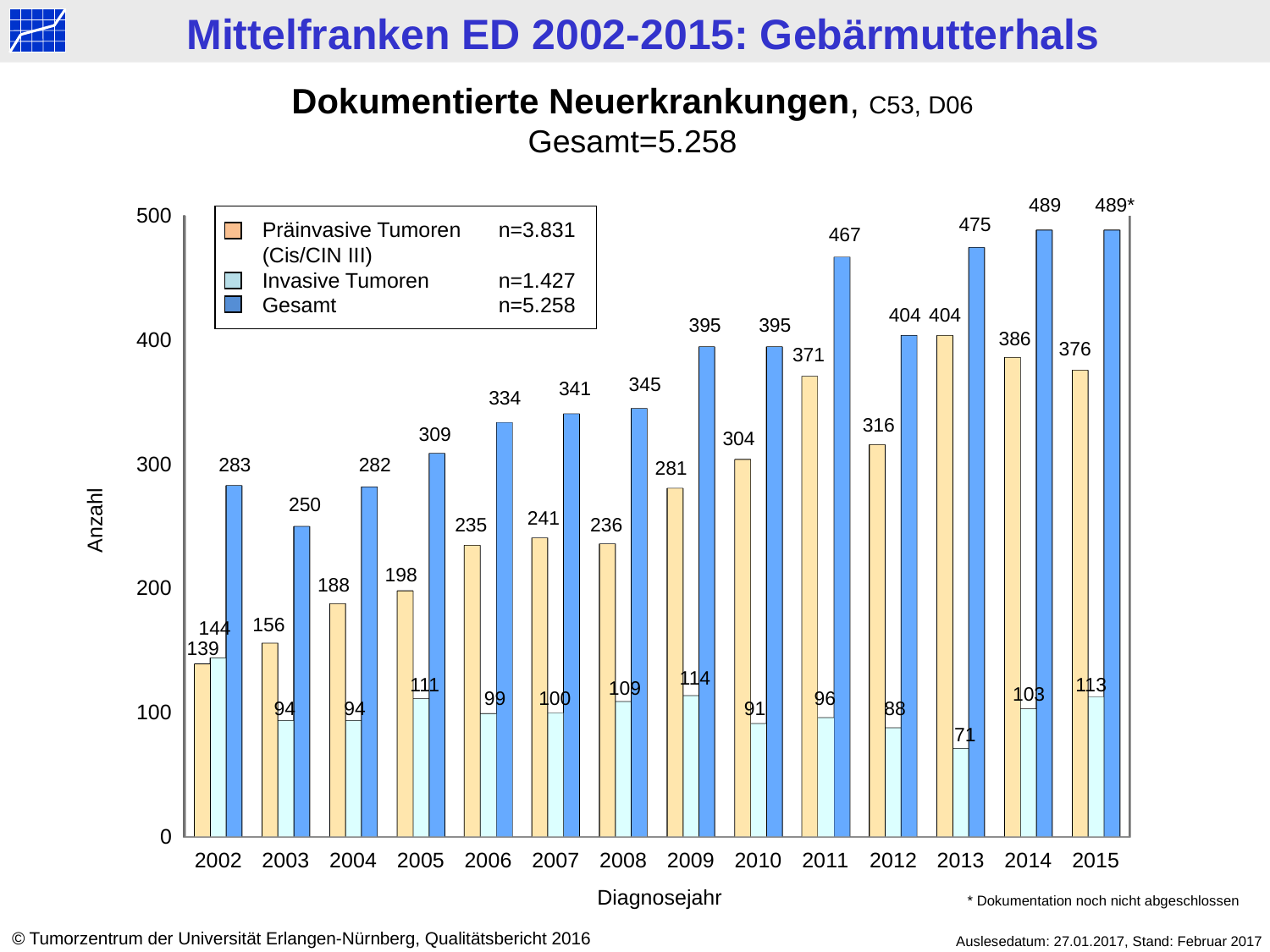
Which is larger, the Präinvasive Tumoren value for 2012 or for 2014? 2014 How many diagnosis years are shown on the x axis? 14 What is the difference between the Gesamt values for 2011 and 2010? 72 What is the total n given in the legend for Invasive Tumoren? n=1.427 In which year is the Invasive Tumoren value lowest? 2013 What is the value for Invasive Tumoren in 2005? 111 How many series does the legend list? 3 In which year is the Präinvasive Tumoren (Cis/CIN III) value highest? 2013 What is the Gesamt value for 2011? 467 What is the value for Präinvasive Tumoren (Cis/CIN III) in 2013? 404 What kind of chart is shown on the slide? bar chart Is the Gesamt value for 2006 greater or less than 300? greater